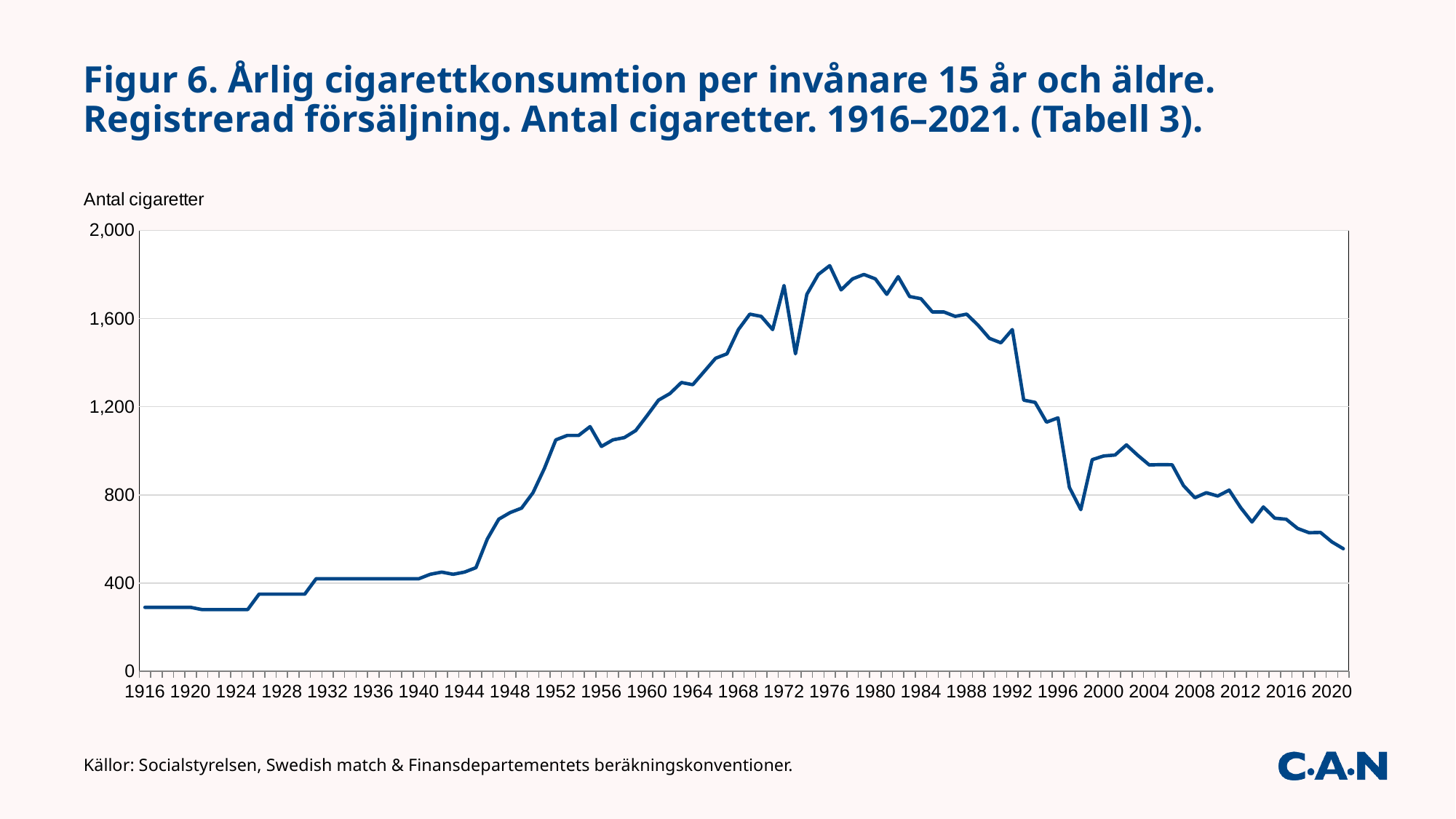
Which year has the larger value, 1916 or 1952? 1952 Is the value for 1952 greater or less than 800? greater Is the value for 1976 greater or less than 1,600? greater Is the value for 1964 greater or less than 1,200? greater Does the line generally rise or fall between 1992 and 2021? fall Which year has the larger value, 1976 or 2020? 1976 What is the label on the vertical axis of the chart? Antal cigaretter What is the first year shown on the x axis of the chart? 1916 How many lines (series) are plotted on the chart? 1 What kind of chart is shown on the slide? line chart